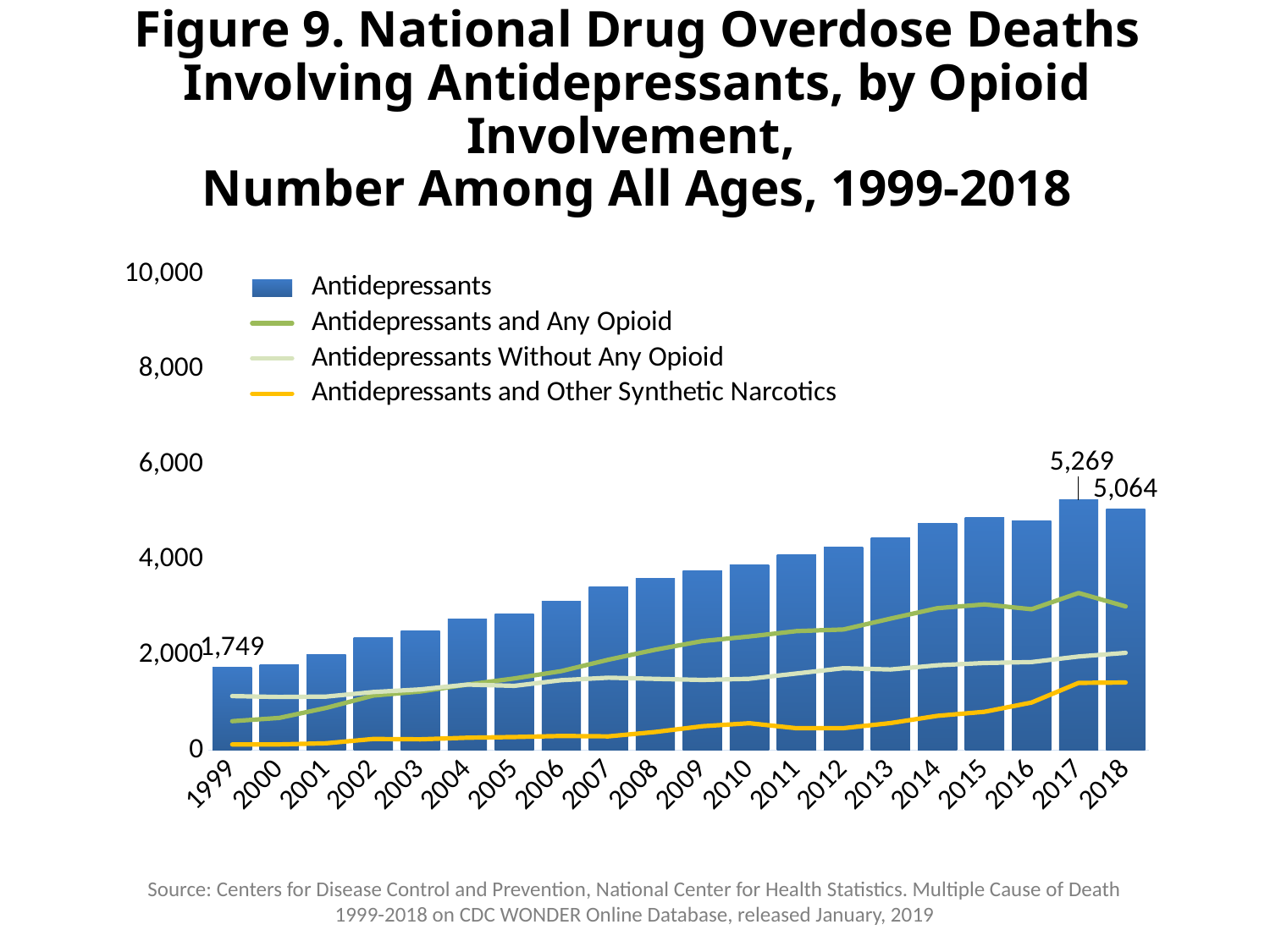
Is the Antidepressants value for 2005 greater or less than 4,000? less What is the difference between the Antidepressants values for 2017 and 2018? 205 By how much did the Antidepressants value increase from 1999 to 2018? 3,315 How many years are shown on the x axis? 20 What is the value of the Antidepressants bar for 2017? 5,269 Which year has the highest Antidepressants bar? 2017 Which year has the lowest Antidepressants bar? 1999 How many series does the legend list? 4 What is the value of the Antidepressants bar for 1999? 1,749 Is the Antidepressants value for 2014 greater or less than 4,000? greater What is the value of the Antidepressants bar for 2018? 5,064 Which is larger, the Antidepressants value for 2017 or for 2018? 2017